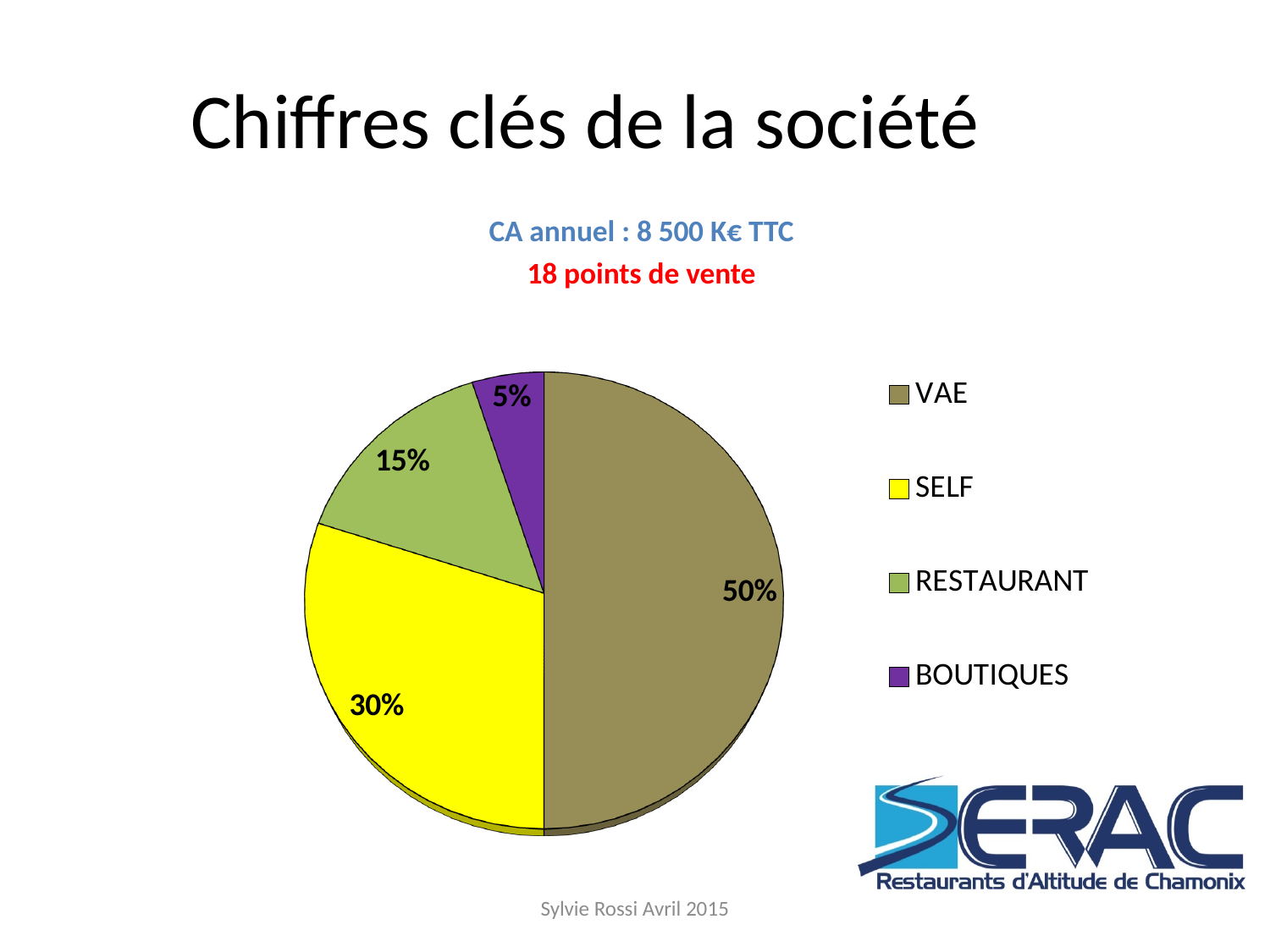
What is the difference in percentage points between the VAE and SELF slices? 20 How many slices does the pie chart have? 4 What kind of chart is shown on the slide? pie chart What colour is the SELF slice in the pie chart? yellow Which legend entry is listed last? BOUTIQUES Which category has the smallest slice of the pie? BOUTIQUES Which slice is larger, RESTAURANT or BOUTIQUES? RESTAURANT What share of the pie does SELF represent? 30% What share of the pie does BOUTIQUES represent? 5% What share of the pie does VAE represent? 50% What share of the pie does RESTAURANT represent? 15% Which category has the largest slice of the pie? VAE